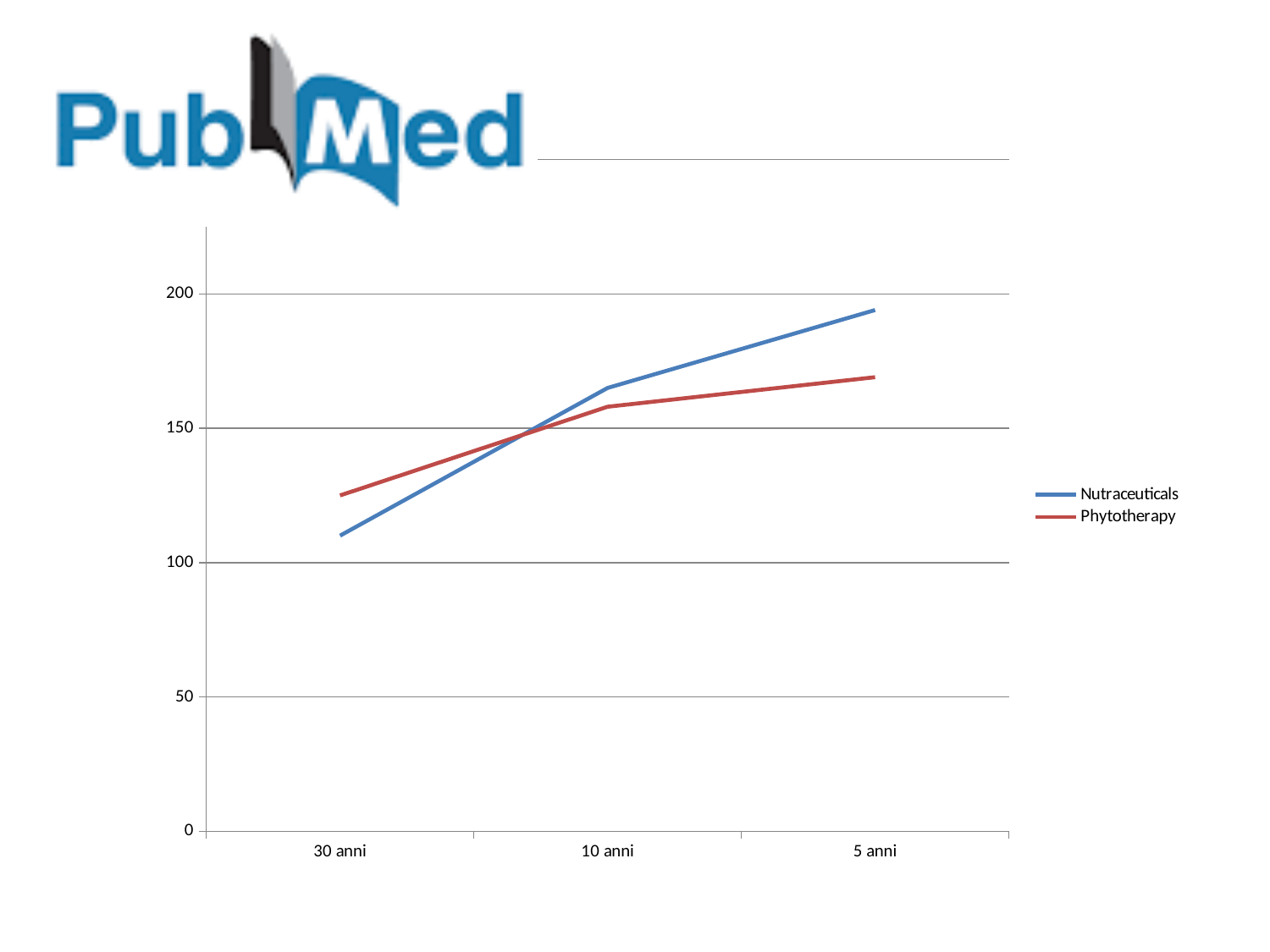
Is the value for Nutraceuticals at 30 anni greater or less than 100? greater What kind of chart is shown on the slide? line chart Does the Phytotherapy line rise or fall from 30 anni to 5 anni? rise How many categories are shown on the x axis? 3 At 5 anni, which series has the higher value, Nutraceuticals or Phytotherapy? Nutraceuticals At which category does the Nutraceuticals series reach its highest value? 5 anni Is the value for Phytotherapy at 30 anni greater or less than 150? less Is the value for Nutraceuticals at 5 anni greater or less than 200? less Which colour is used for the Phytotherapy series? red At 30 anni, which series has the higher value, Nutraceuticals or Phytotherapy? Phytotherapy Does the Nutraceuticals line rise or fall from 30 anni to 5 anni? rise How many series does the legend list? 2